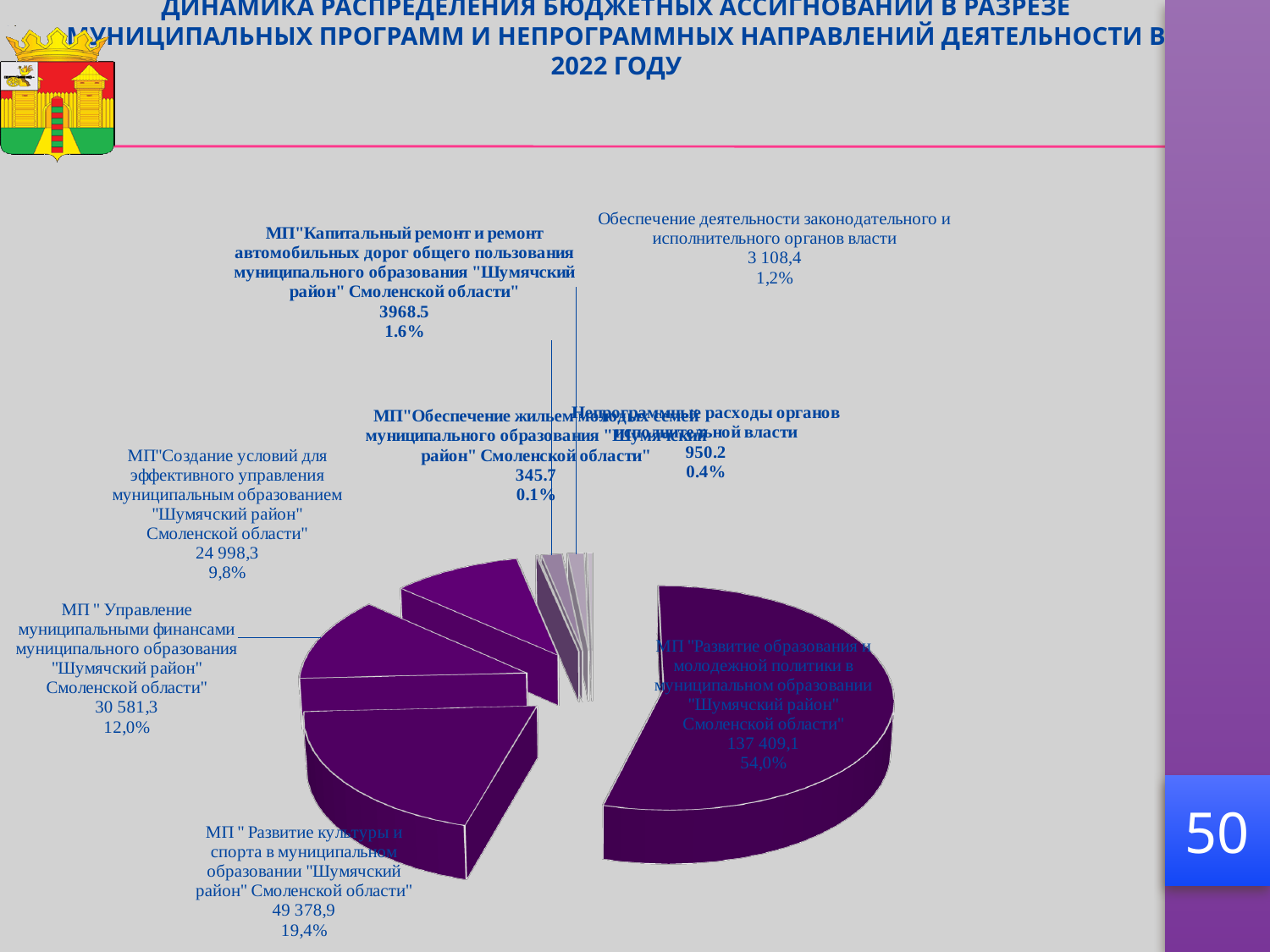
What kind of chart is shown on the slide? Pie chart How many slices does the pie chart have? 8 What share of the pie does МП "Создание условий для эффективного управления муниципальным образованием" account for? 9,8% What is the difference between the values for МП "Развитие культуры и спорта" and МП "Управление муниципальными финансами"? 18 797,6 Which is larger: the value for МП "Капитальный ремонт и ремонт автомобильных дорог" or the value for Обеспечение деятельности законодательного и исполнительного органов власти? МП "Капитальный ремонт и ремонт автомобильных дорог" What value is shown for МП "Управление муниципальными финансами"? 30 581,3 What value is shown for МП "Развитие образования и молодежной политики"? 137 409,1 Which category has the largest slice of the pie chart? МП "Развитие образования и молодежной политики в муниципальном образовании "Шумячский район" Смоленской области" What share of the pie does Обеспечение деятельности законодательного и исполнительного органов власти account for? 1,2% What value is shown for Непрограммные расходы органов исполнительной власти? 950.2 Which category has the smallest slice of the pie chart? МП "Обеспечение жильем молодых семей муниципального образования "Шумячский район" Смоленской области" What share of the pie does МП "Развитие культуры и спорта" account for? 19,4%